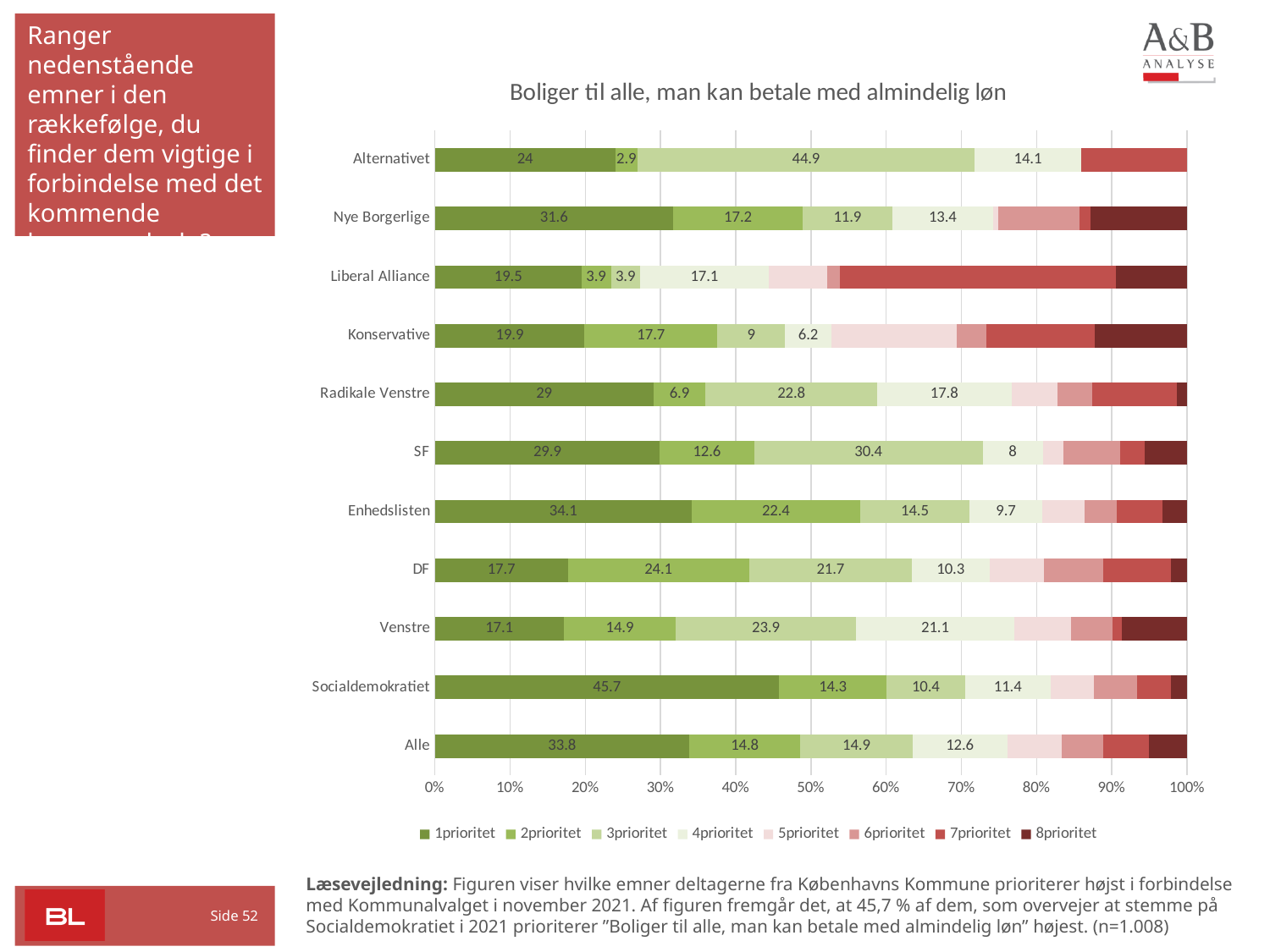
What kind of chart is shown on the slide? Stacked bar chart Which is larger, the 3prioritet value for SF or the 3prioritet value for Radikale Venstre? SF How many series does the legend list? 8 How many categories (parties/groups) are shown on the y axis? 11 What is the 3prioritet value for Alternativet? 44.9 What is the 4prioritet value for Venstre? 21.1 What is the difference between the 1prioritet values for Enhedslisten and Alle? 0.3 What is the 2prioritet value for DF? 24.1 Which category has the highest 1prioritet value? Socialdemokratiet What is the title of the chart? Boliger til alle, man kan betale med almindelig løn Which category has the lowest 1prioritet value? Venstre What is the 1prioritet value for Socialdemokratiet? 45.7